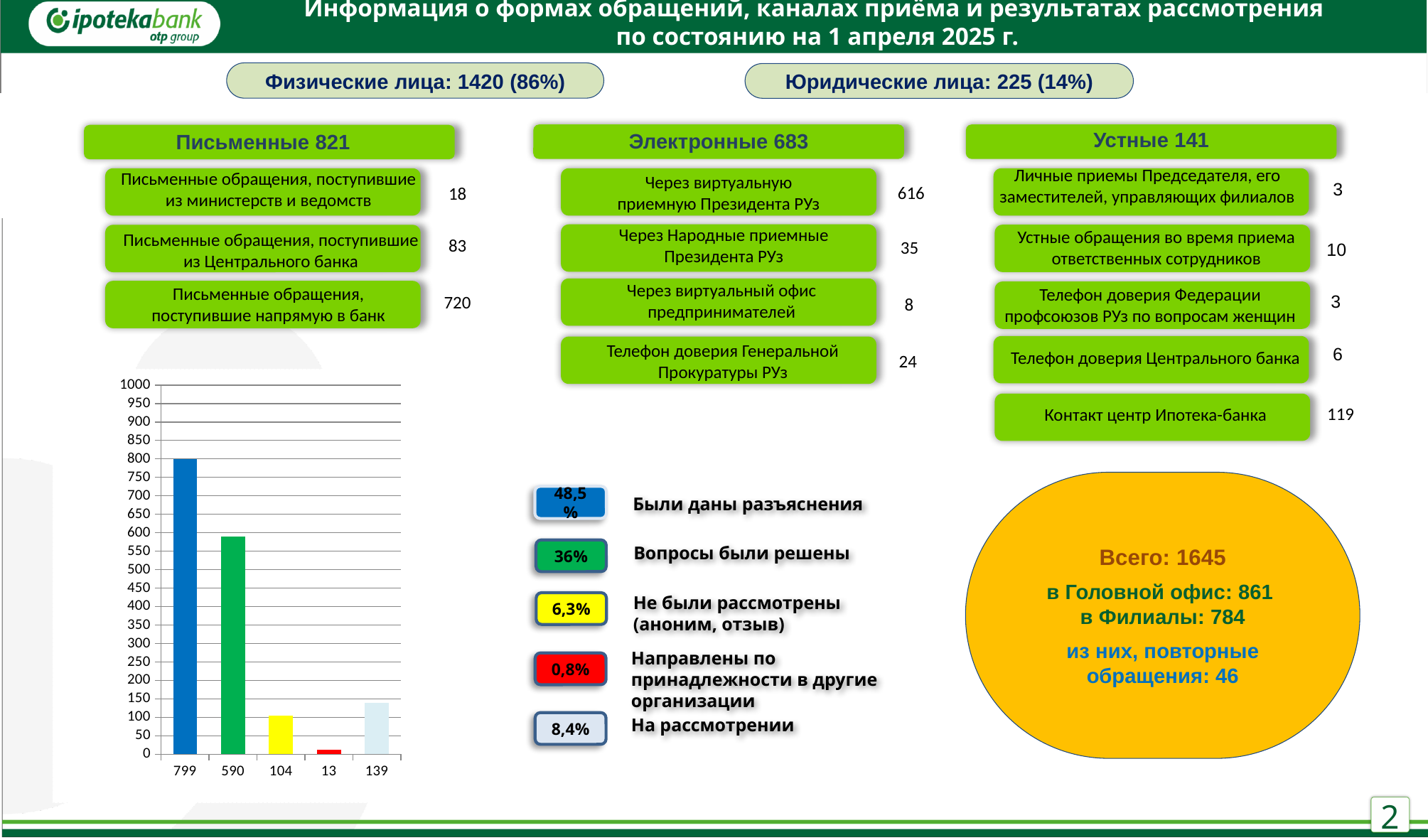
In the bar chart, what value is labelled under the blue bar? 799 What is the maximum value shown on the y-axis of the bar chart? 1000 How many bars does the bar chart at the bottom left contain? 5 In the bar chart, what is the difference between the blue bar (799) and the green bar (590)? 209 In the bar chart, what value is labelled under the green bar? 590 In the bar chart, which bar is taller: the yellow bar or the light blue bar? the light blue bar Which value in the bar chart corresponds to the shortest bar? 13 Which value in the bar chart corresponds to the tallest bar? 799 In the bar chart, is the value of the blue bar greater or less than 750? greater In the bar chart, what is the difference between the light blue bar (139) and the yellow bar (104)? 35 In the bar chart, what value is labelled under the red bar? 13 What type of chart is shown at the bottom left of the slide? bar chart